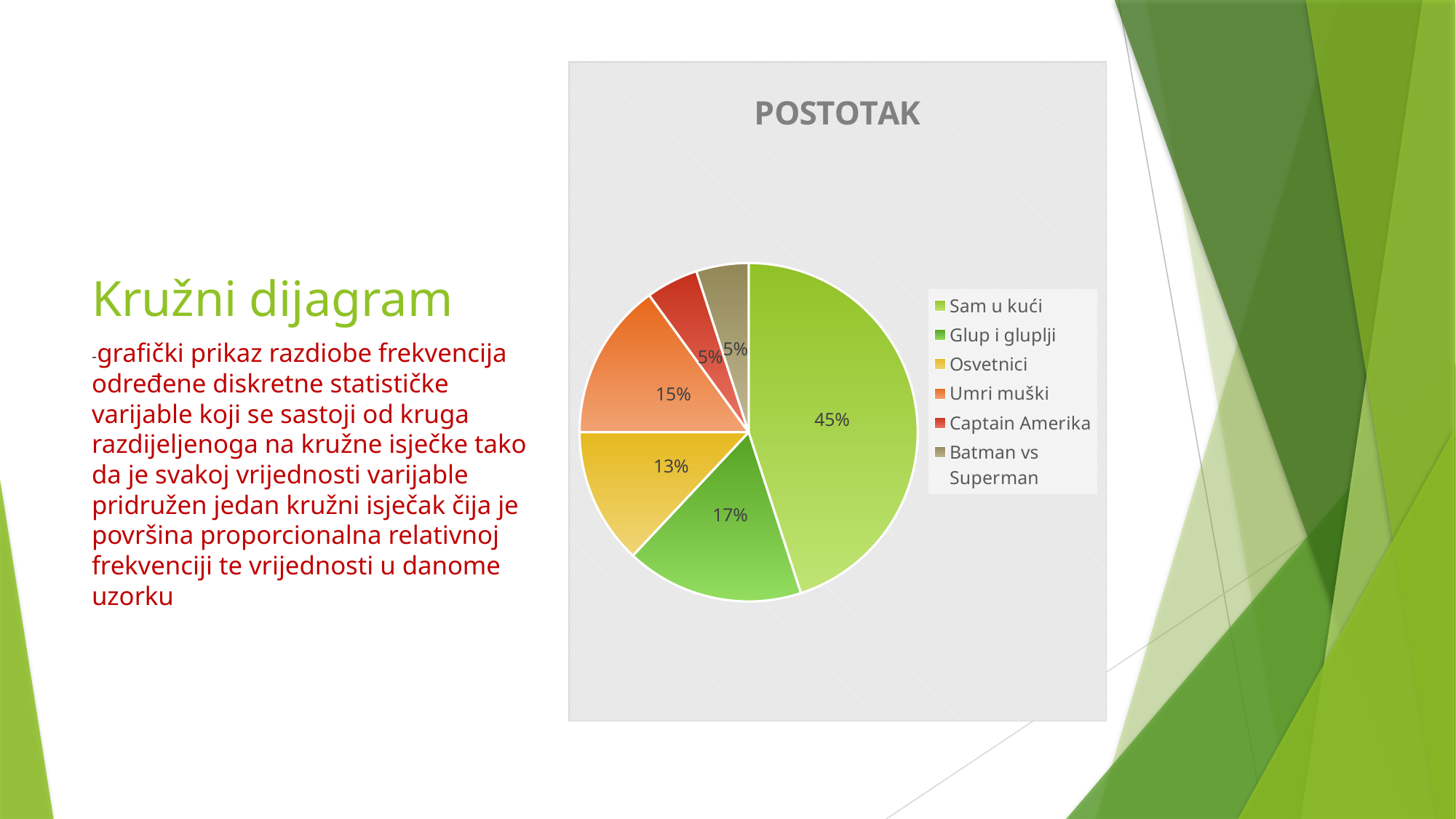
How many categories does the legend list? 6 What is the title of the chart? POSTOTAK What colour is the slice for Batman vs Superman? brownish grey What is the difference in percentage points between Sam u kući and Glup i gluplji? 28 What percentage does the slice for Osvetnici represent? 13% What percentage does the slice for Captain Amerika represent? 5% What percentage does the slice for Sam u kući represent? 45% What type of chart is shown on the slide? pie chart Which is larger, the slice for Umri muški or the slice for Osvetnici? Umri muški Which category has the largest slice of the pie? Sam u kući What percentage does the slice for Umri muški represent? 15% What percentage does the slice for Glup i gluplji represent? 17%